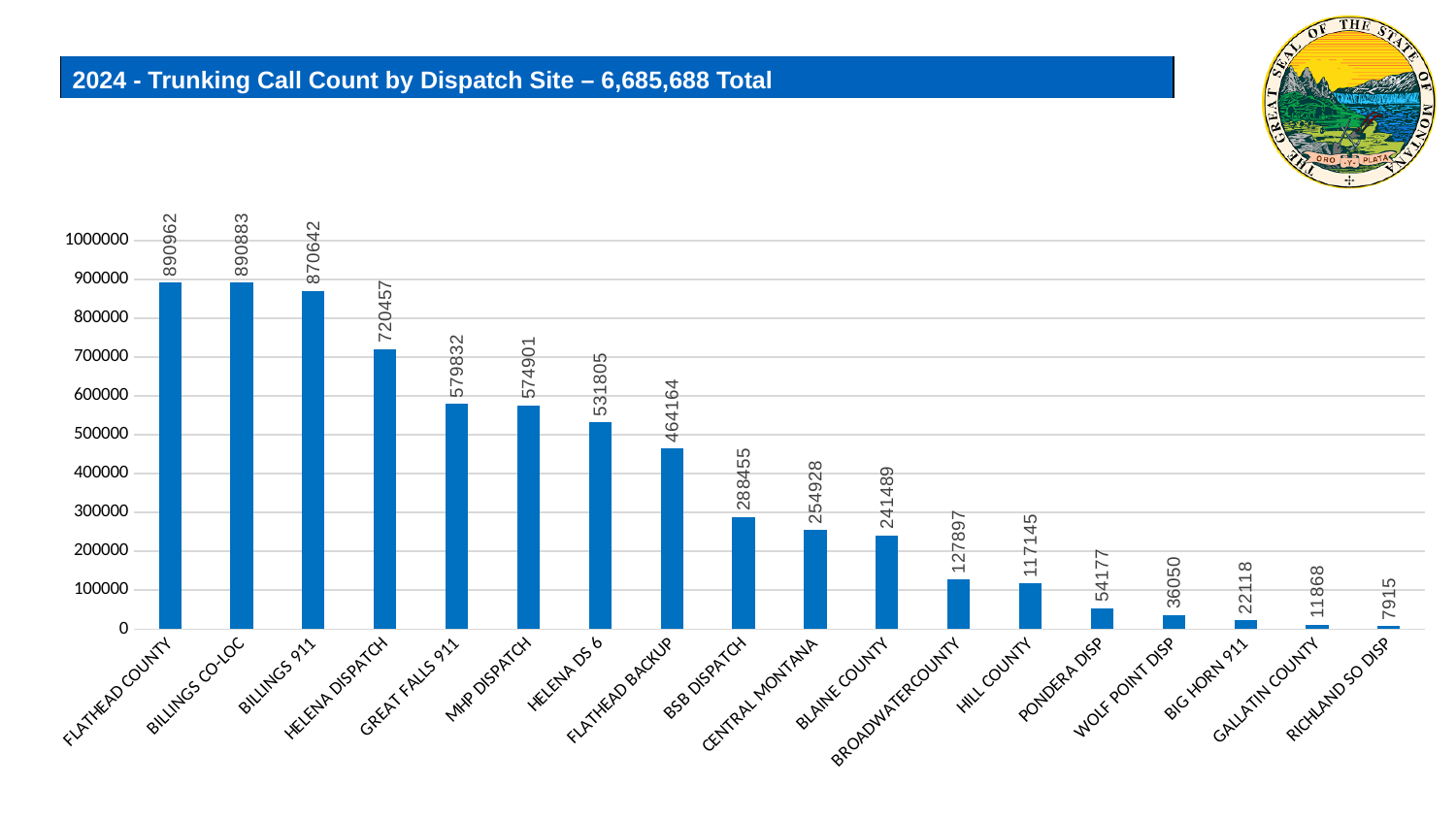
Is the value for BSB DISPATCH greater or less than 300000? less Which dispatch site has the highest trunking call count? FLATHEAD COUNTY Do the call counts rise or fall moving from left to right along the x axis? fall What is the trunking call count for WOLF POINT DISP? 36050 What is the difference between the call counts for HILL COUNTY and PONDERA DISP? 62968 What is the trunking call count for BLAINE COUNTY? 241489 What is the difference between the call counts for HELENA DISPATCH and GREAT FALLS 911? 140625 What kind of chart is shown on the slide? bar chart Which dispatch site has the lowest trunking call count? RICHLAND SO DISP Which has a larger call count, MHP DISPATCH or FLATHEAD BACKUP? MHP DISPATCH What is the trunking call count for HELENA DISPATCH? 720457 How many dispatch sites are shown on the chart? 18